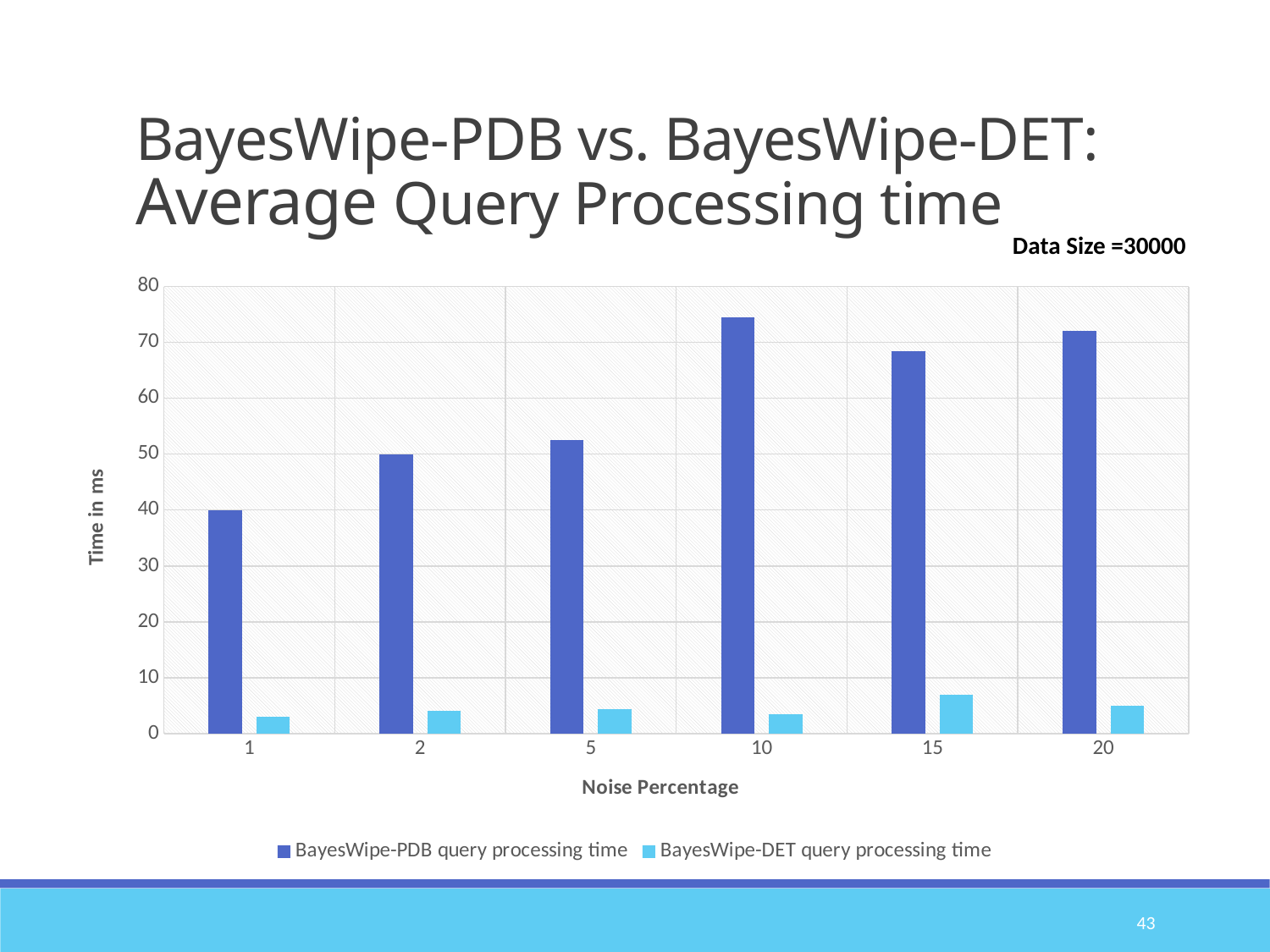
Is the BayesWipe-PDB query processing time at noise percentage 10 greater or less than 60? greater What is the label of the y axis? Time in ms What kind of chart is shown on the slide? bar chart At which noise percentage is the BayesWipe-DET query processing time highest? 15 Does the BayesWipe-PDB query processing time rise or fall from noise percentage 1 to noise percentage 10? rise Is the BayesWipe-DET query processing time at noise percentage 15 greater or less than 10? less How many noise percentage categories are shown on the x axis? 6 How many series does the legend list? 2 Which is larger: the BayesWipe-PDB query processing time at noise percentage 10 or at noise percentage 1? noise percentage 10 At which noise percentage is the BayesWipe-PDB query processing time lowest? 1 Which series has the larger value at noise percentage 20, BayesWipe-PDB or BayesWipe-DET? BayesWipe-PDB query processing time Is the BayesWipe-PDB query processing time at noise percentage 1 greater or less than 50? less